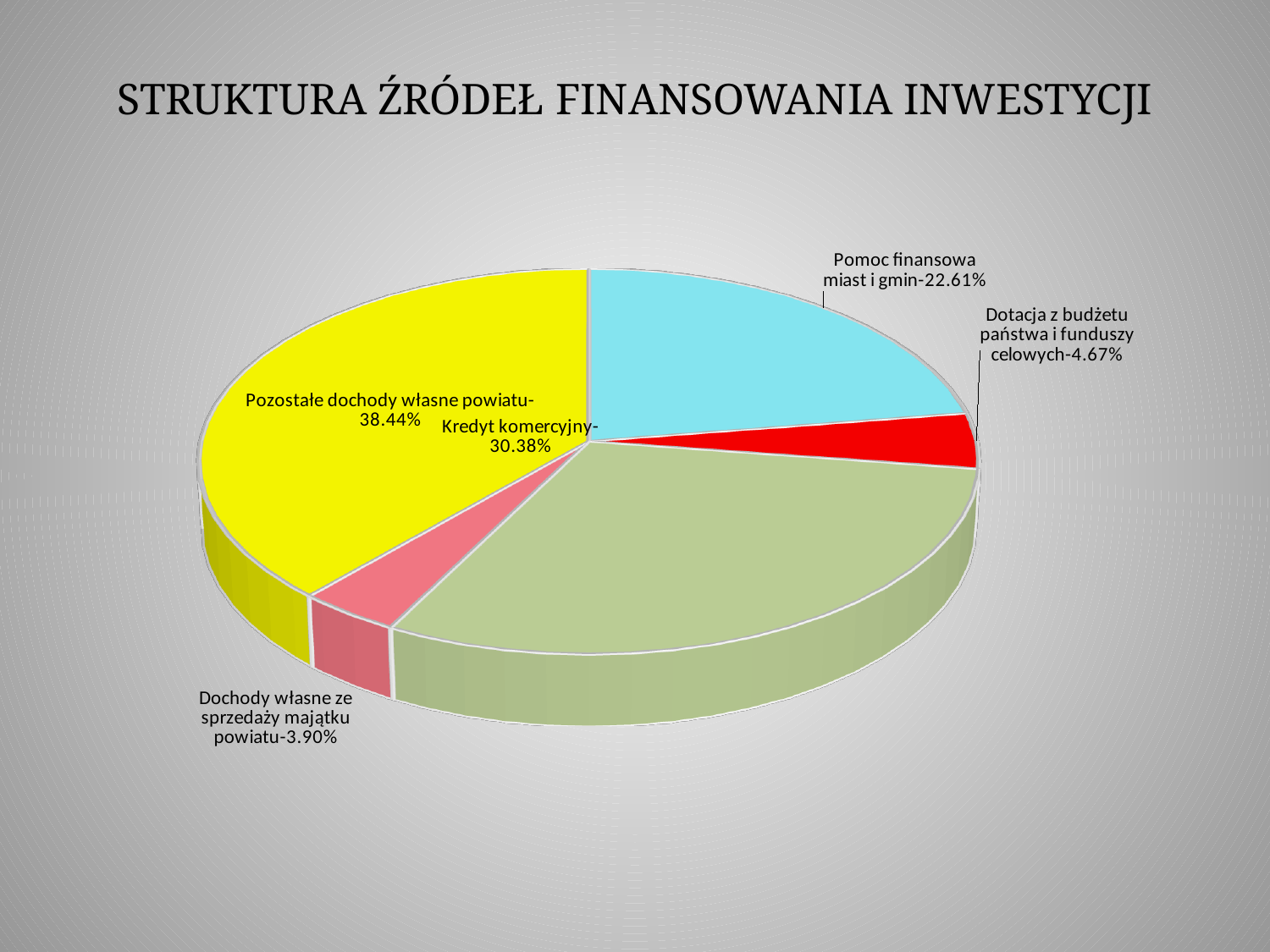
Which source has the smallest share of the pie? Dochody własne ze sprzedaży majątku powiatu What is the title of the chart? STRUKTURA ŹRÓDEŁ FINANSOWANIA INWESTYCJI What share does "Dochody własne ze sprzedaży majątku powiatu" have? 3.90% How many slices does the pie chart have? 5 Which source has the largest share of the pie? Pozostałe dochody własne powiatu What share does "Pomoc finansowa miast i gmin" have? 22.61% What share does "Kredyt komercyjny" have? 30.38% What share does "Dotacja z budżetu państwa i funduszy celowych" have? 4.67% What is the difference in percentage points between "Pozostałe dochody własne powiatu" and "Kredyt komercyjny"? 8.06 What kind of chart is shown on the slide? Pie chart What share does "Pozostałe dochody własne powiatu" have? 38.44% Which is larger: the share of "Kredyt komercyjny" or the share of "Pomoc finansowa miast i gmin"? Kredyt komercyjny